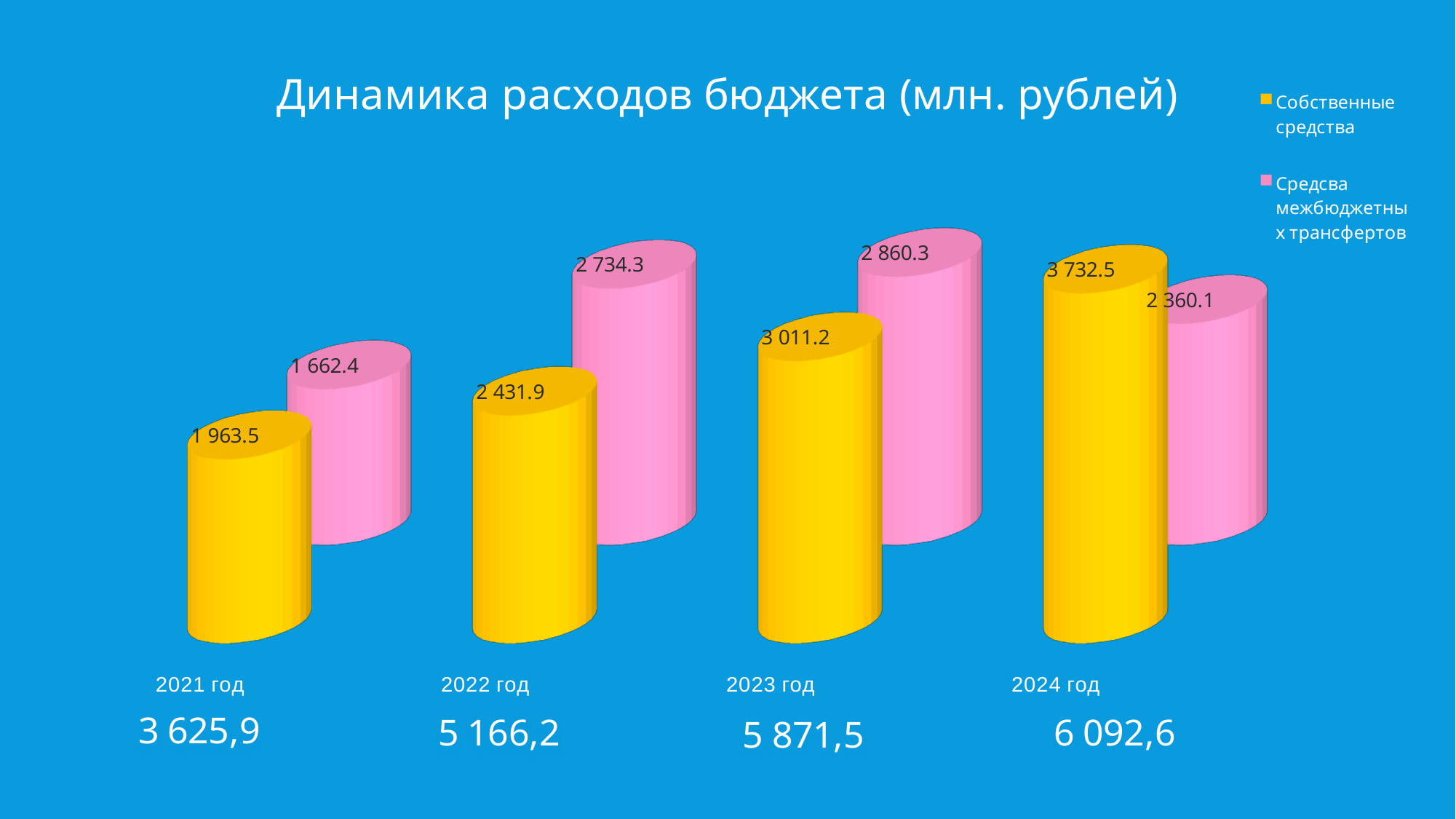
What is the value of Средсва межбюджетных трансфертов for 2022 год? 2 734.3 What is the total budget expenditure shown for 2023 год? 5 871,5 Do the values of Собственные средства rise or fall from 2021 год to 2024 год? Rise How many years are shown on the chart? 4 How many series does the legend list? 2 What is the value of Собственные средства for 2021 год? 1 963.5 In which year is Собственные средства the highest? 2024 год In 2022 год, which is larger: Собственные средства or Средсва межбюджетных трансфертов? Средсва межбюджетных трансфертов In which year is Средсва межбюджетных трансфертов the lowest? 2021 год What kind of chart is shown on the slide? Bar chart What is the value of Собственные средства for 2024 год? 3 732.5 What is the difference between Собственные средства and Средсва межбюджетных трансфертов in 2024 год? 1 372.4